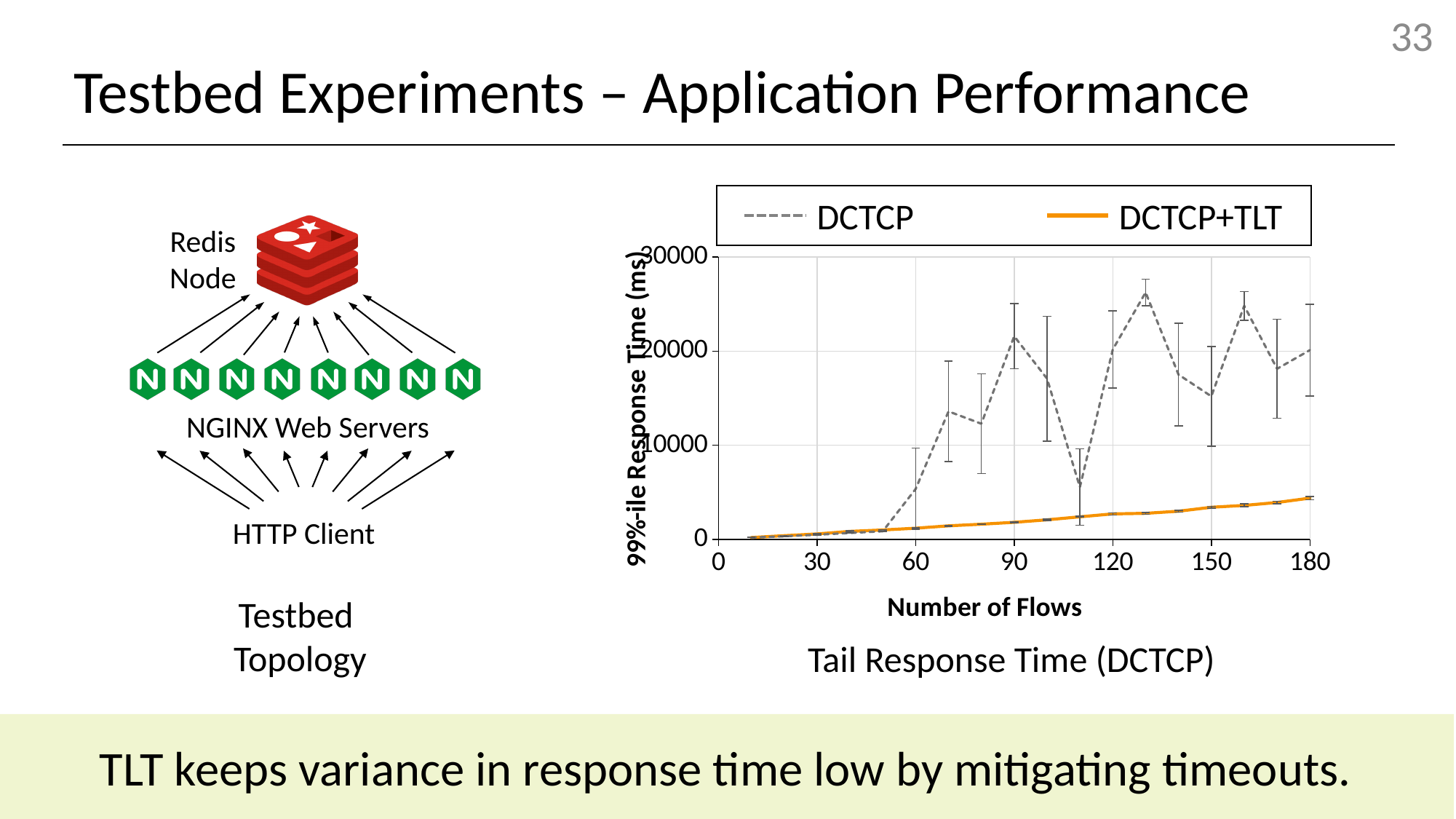
At 90 flows, which series has the higher 99%-ile response time, DCTCP or DCTCP+TLT? DCTCP Which series reaches the highest 99%-ile response time anywhere on the chart? DCTCP What is the label of the chart's y axis? 99%-ile Response Time (ms) Is the DCTCP value at 110 flows greater or less than 10000? less At 160 flows, which series has the lower 99%-ile response time? DCTCP+TLT What kind of chart is shown on the slide? line chart Is the DCTCP+TLT value at 180 flows greater or less than 10000? less Is the DCTCP value at 130 flows greater or less than 20000? greater How many series does the chart's legend list? 2 What are the two series named in the chart's legend? DCTCP and DCTCP+TLT Does the DCTCP+TLT line rise or fall as the number of flows increases? rises